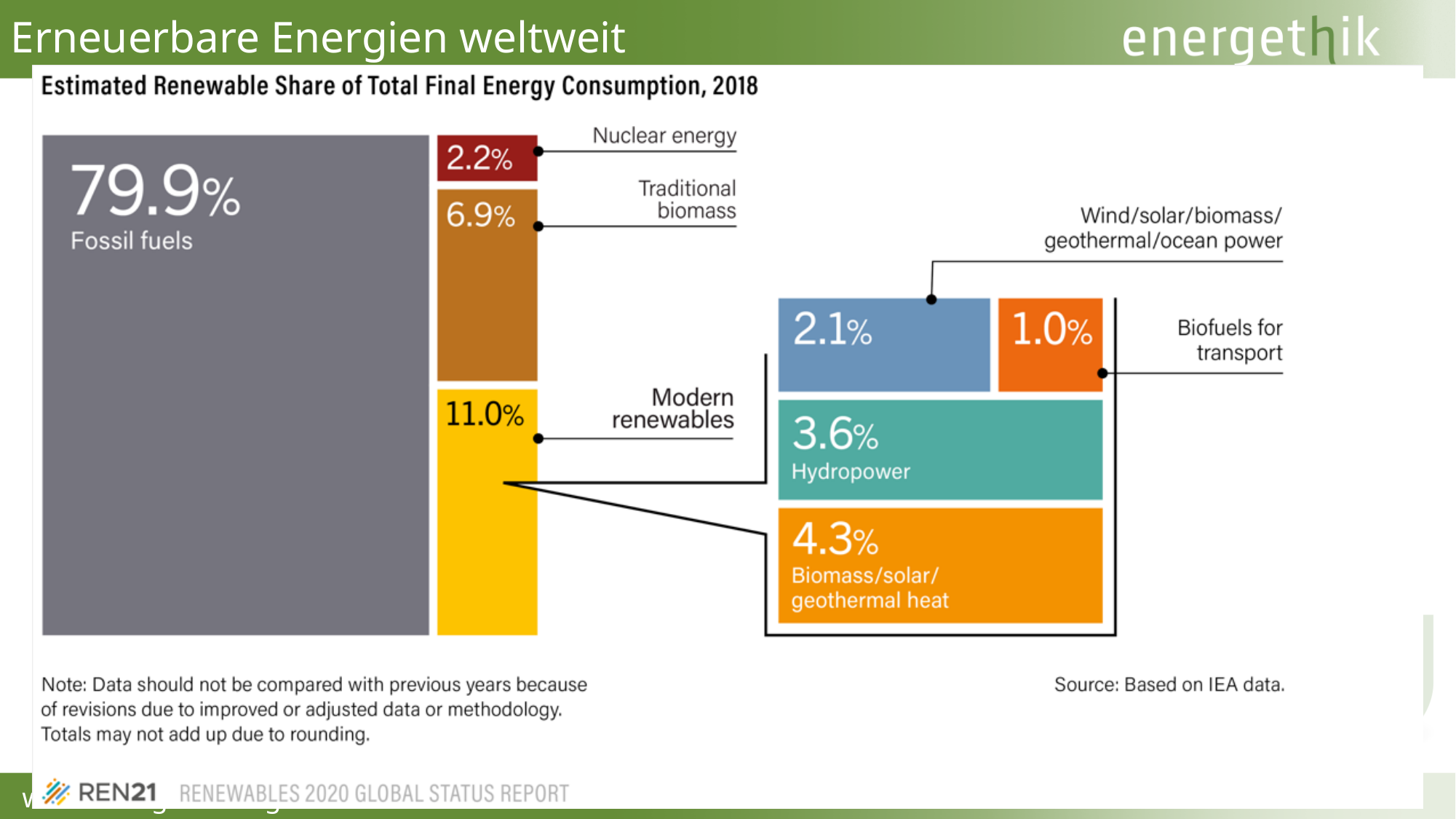
What is the share of biofuels for transport? 1.0% What share does nuclear energy have according to the chart? 2.2% What is the share of traditional biomass? 6.9% What is the share of fossil fuels in total final energy consumption shown on the chart? 79.9% What year does the chart's data refer to? 2018 Which is larger: the share of hydropower or the share of biomass/solar/geothermal heat? Biomass/solar/geothermal heat What share does hydropower contribute within modern renewables? 3.6% What is the share of modern renewables? 11.0% What is the difference between the share of traditional biomass and the share of nuclear energy? 4.7% Which component of modern renewables has the smallest share? Biofuels for transport What is the source of the data according to the chart? Based on IEA data Which category has the largest share of total final energy consumption? Fossil fuels